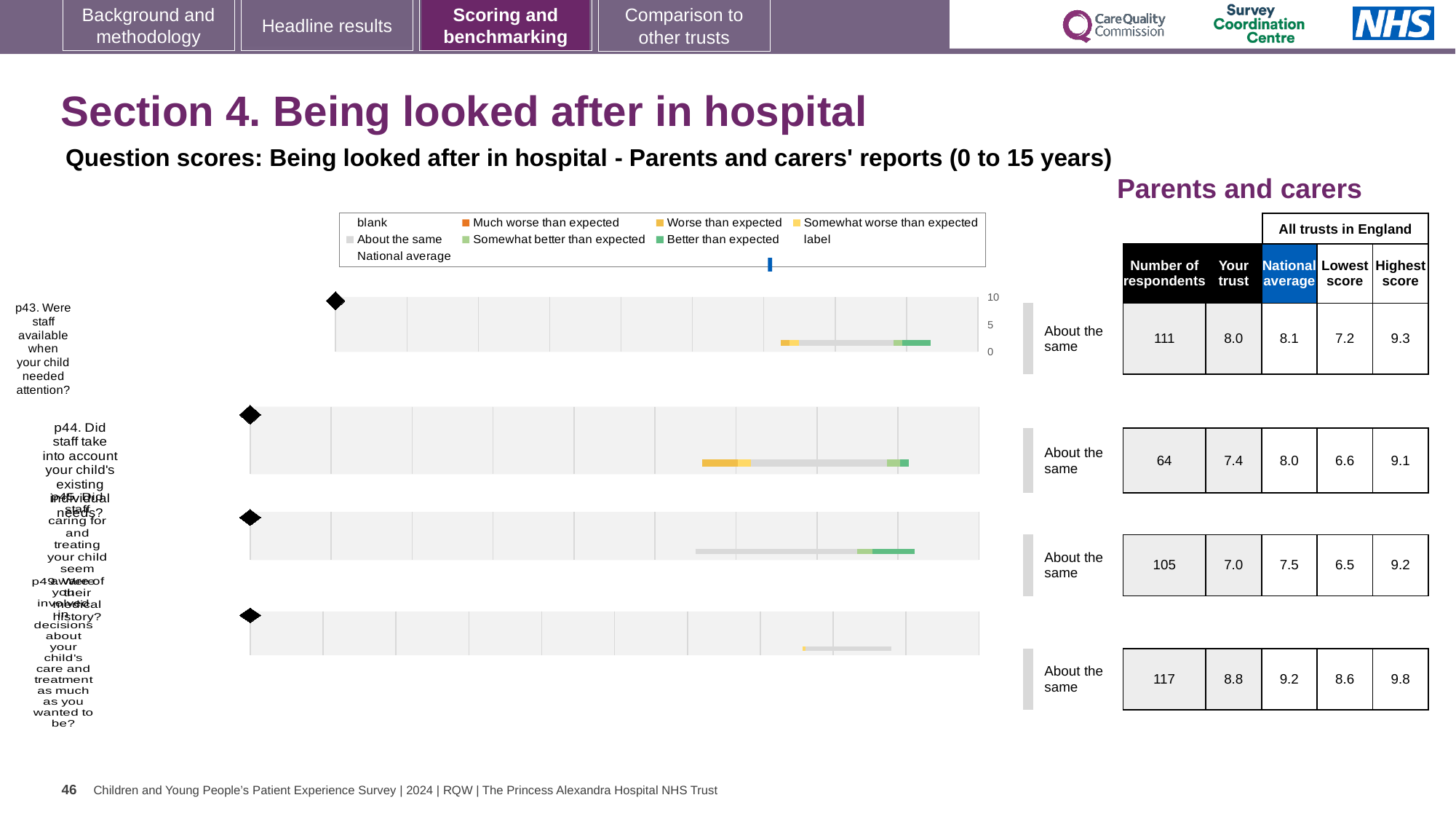
For question p43, which is larger: the 'Your trust' score or the national average? National average What is the highest score among all trusts in England for question p45? 9.2 Which question has the lowest 'Your trust' score? p45 How many questions are plotted on the slide? 4 What is the 'Your trust' score for p43 (Were staff available when your child needed attention?)? 8.0 What kind of chart is used to show each question's score? Bar chart What is the national average score for p44 (Did staff take into account your child's existing individual needs?)? 8.0 For question p44, what is the difference between the national average and the 'Your trust' score? 0.6 What benchmark category is shown for all four questions? About the same Which question has the highest 'Your trust' score? p49 How many respondents answered question p49? 117 What is the lowest score among all trusts in England for question p43? 7.2